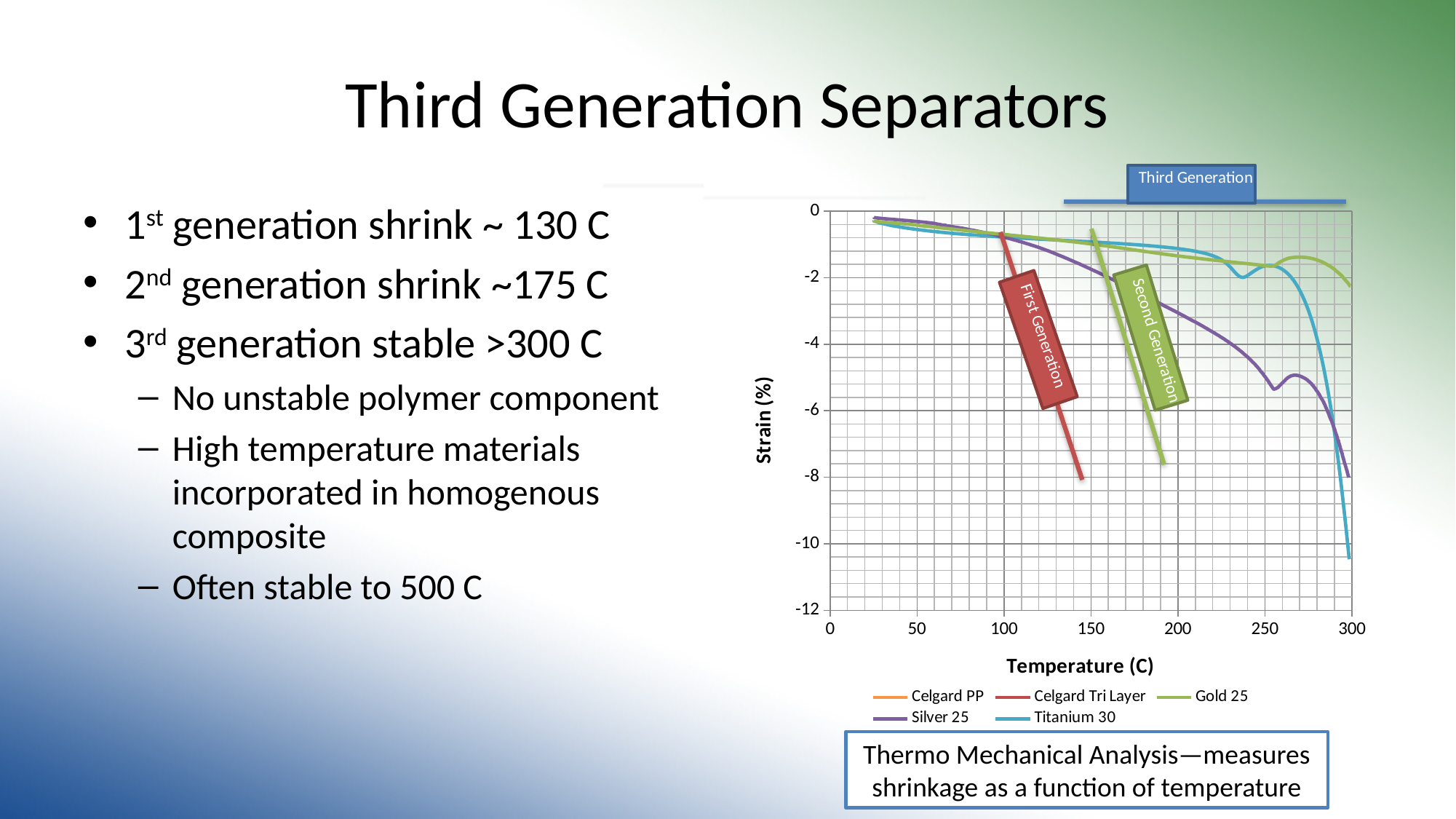
How many series does the chart legend list? 5 What is the label of the x axis of the chart? Temperature (C) What is the label of the y axis of the chart? Strain (%) Is the strain for Titanium 30 at 300 C greater or less than -10? less What is the lowest value shown on the y axis of the chart? -12 At 300 C, which series has the lower strain, Titanium 30 or Silver 25? Titanium 30 What kind of chart is shown on the slide? Line chart Does the strain for Silver 25 rise or fall as temperature increases? Fall Which series stays closest to 0% strain across the whole temperature range? Gold 25 Is the strain for Gold 25 at 300 C greater or less than -4? greater Is the lowest strain reached by the Celgard Tri Layer series greater or less than -6? less Which series reaches the lowest strain value on the chart? Titanium 30